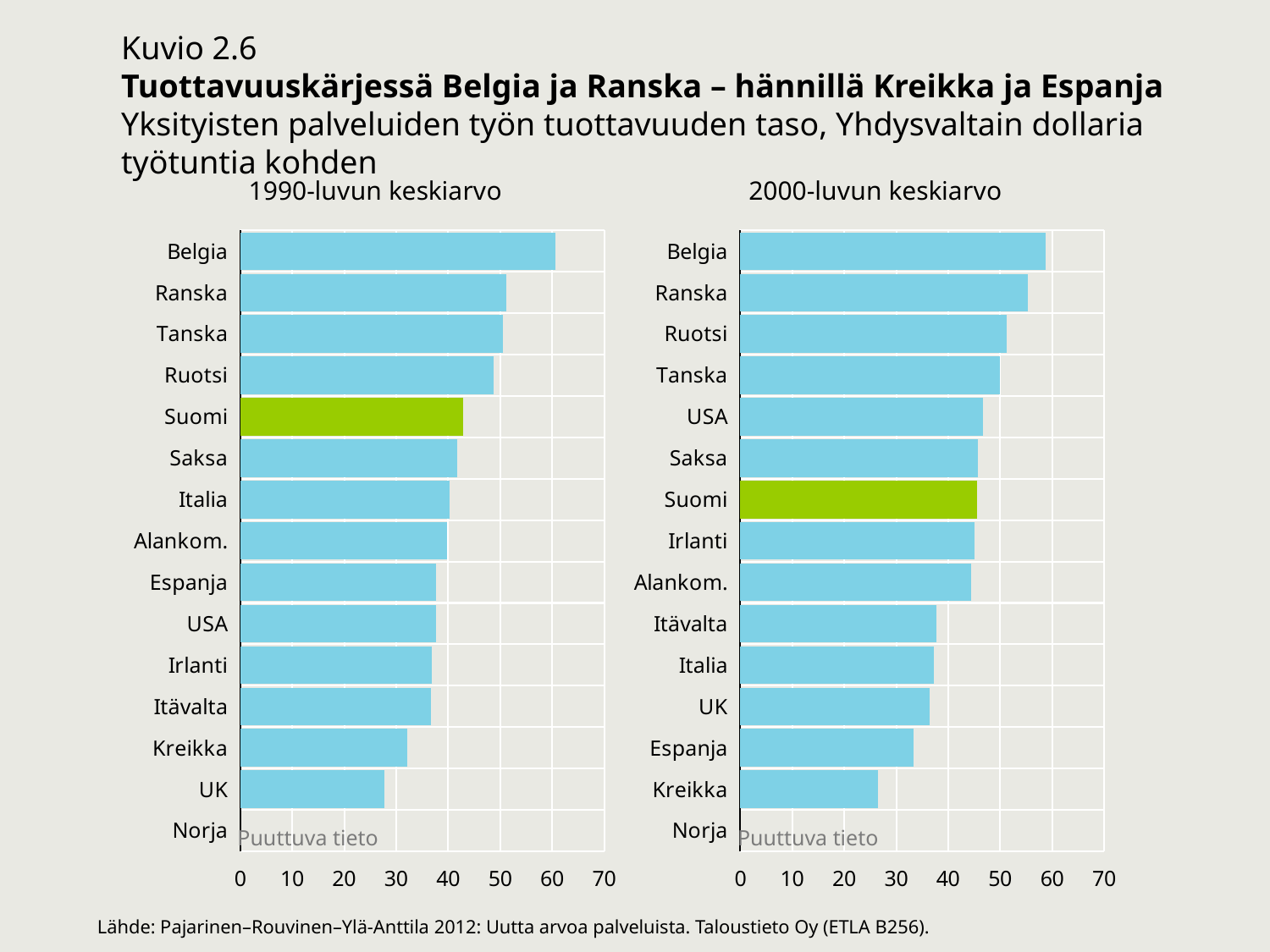
In the 2000-luvun keskiarvo chart, is the value for Kreikka greater or less than 30? less Which country's bar is highlighted in green in both charts? Suomi In the 1990-luvun keskiarvo chart, which country has the highest value? Belgia In the 2000-luvun keskiarvo chart, which country has the lowest plotted value? Kreikka What kind of chart is used on the slide for the 1990-luvun keskiarvo panel? bar chart In the 1990-luvun keskiarvo chart, which country has the lowest plotted value? UK In the 2000-luvun keskiarvo chart, which country has the highest value? Belgia In the 2000-luvun keskiarvo chart, is the value for Ranska greater or less than 50? greater In the 1990-luvun keskiarvo chart, is the value for Suomi greater or less than 40? greater In the 2000-luvun keskiarvo chart, which is larger, the value for Espanja or the value for Kreikka? Espanja How many countries are listed on the axis of the 2000-luvun keskiarvo chart? 15 In the 1990-luvun keskiarvo chart, which is larger, the value for Belgia or the value for Ranska? Belgia